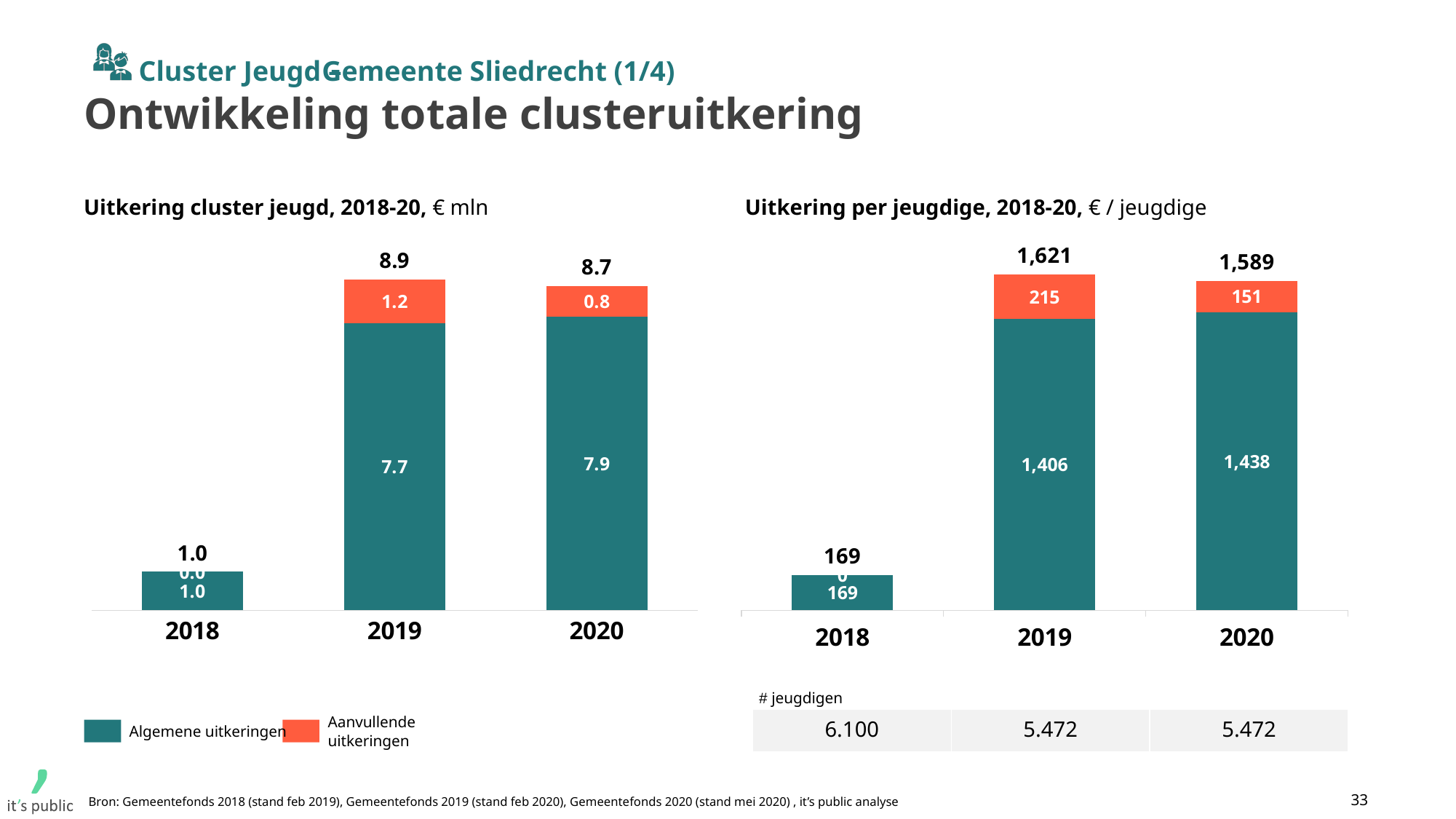
In the left chart 'Uitkering cluster jeugd, 2018-20', which year has the lowest total? 2018 What kind of chart is the left chart 'Uitkering cluster jeugd, 2018-20'? Stacked bar chart In the left chart 'Uitkering cluster jeugd, 2018-20', what is the value of Algemene uitkeringen for 2019? 7.7 In the right chart 'Uitkering per jeugdige, 2018-20', what is the difference between the totals for 2019 and 2020? 32 In the right chart 'Uitkering per jeugdige, 2018-20', which year has the highest total? 2019 In the right chart 'Uitkering per jeugdige, 2018-20', is the Aanvullende uitkeringen value larger for 2019 or 2020? 2019 How many series does the legend list for the charts on the slide? 2 In the left chart 'Uitkering cluster jeugd, 2018-20', what is the total of the stacked bar for 2019? 8.9 In the left chart 'Uitkering cluster jeugd, 2018-20', what is the difference between the Aanvullende uitkeringen values for 2019 and 2020? 0.4 In the right chart 'Uitkering per jeugdige, 2018-20', what is the total of the stacked bar for 2019? 1,621 In the right chart 'Uitkering per jeugdige, 2018-20', what is the value of Algemene uitkeringen for 2020? 1,438 In the left chart 'Uitkering cluster jeugd, 2018-20', what is the value of Aanvullende uitkeringen for 2020? 0.8